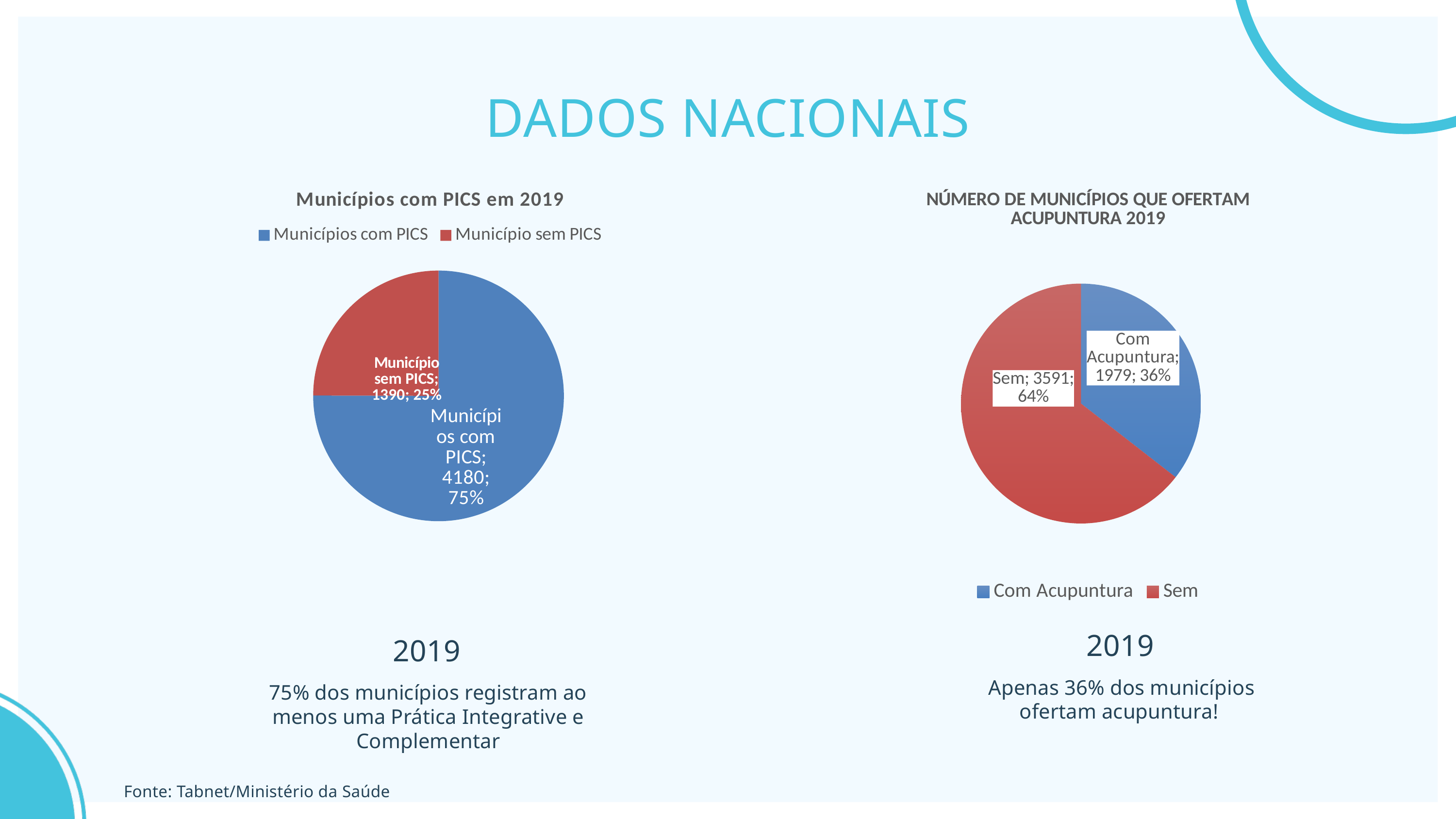
In the 'Municípios com PICS em 2019' chart, what kind of chart is shown? Pie chart In the 'Municípios com PICS em 2019' chart, what is the difference between Municípios com PICS and Município sem PICS? 2790 In the 'NÚMERO DE MUNICÍPIOS QUE OFERTAM ACUPUNTURA 2019' chart, what is the value for Sem? 3591 In the 'NÚMERO DE MUNICÍPIOS QUE OFERTAM ACUPUNTURA 2019' chart, what is the value for Com Acupuntura? 1979 In the 'NÚMERO DE MUNICÍPIOS QUE OFERTAM ACUPUNTURA 2019' chart, what colour is the Sem slice? Red In the 'Municípios com PICS em 2019' chart, what is the value for Município sem PICS? 1390 In the 'NÚMERO DE MUNICÍPIOS QUE OFERTAM ACUPUNTURA 2019' chart, what is the difference between Sem and Com Acupuntura? 1612 In the 'NÚMERO DE MUNICÍPIOS QUE OFERTAM ACUPUNTURA 2019' chart, what share of the pie is Com Acupuntura? 36% In the 'NÚMERO DE MUNICÍPIOS QUE OFERTAM ACUPUNTURA 2019' chart, which category is largest? Sem In the 'Municípios com PICS em 2019' chart, what is the value for Municípios com PICS? 4180 In the 'Municípios com PICS em 2019' chart, what share of the pie is Município sem PICS? 25% In the 'Municípios com PICS em 2019' chart, how many slices does the pie have? 2